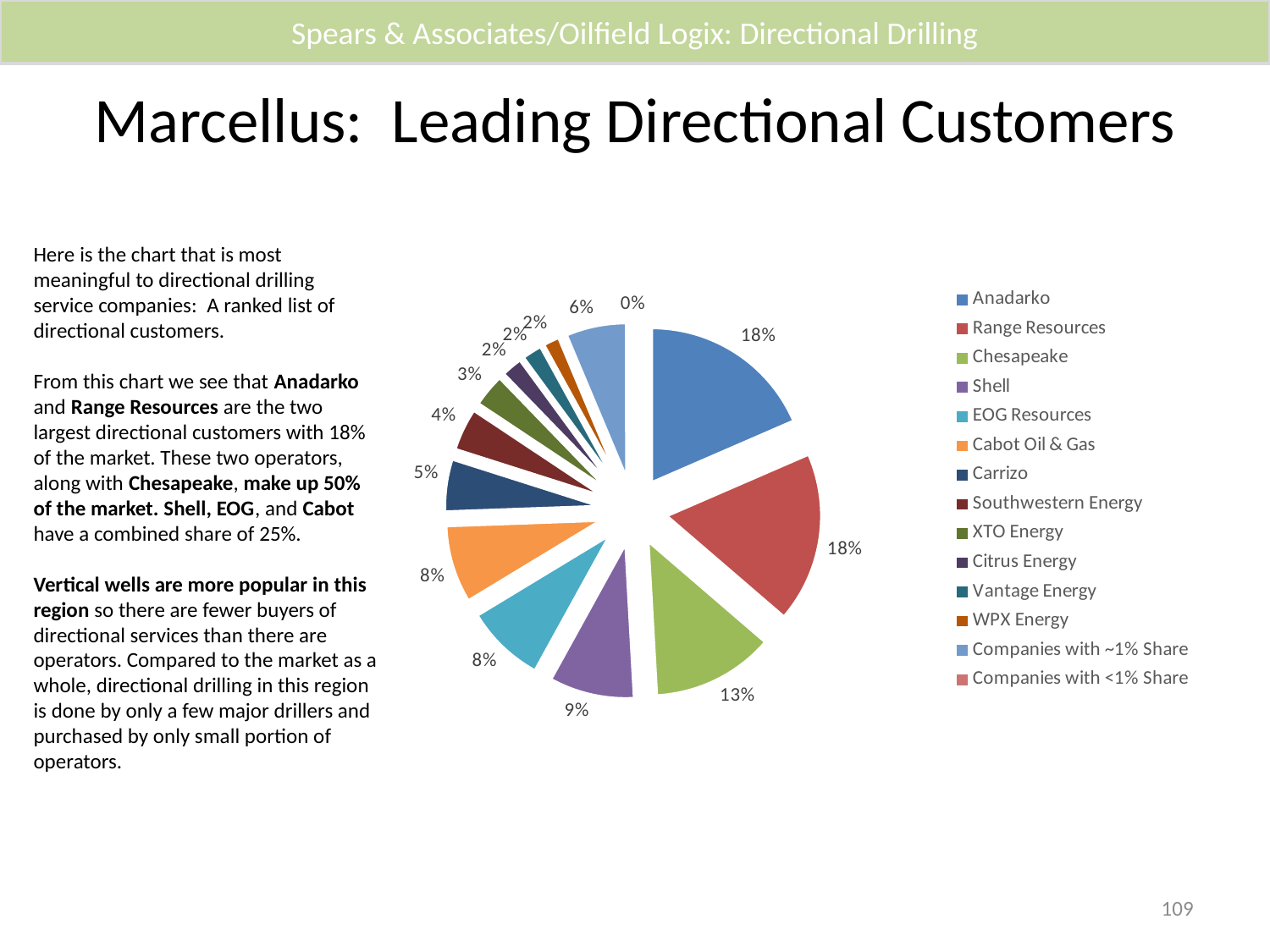
What share of the pie does Shell hold? 9% How many entries does the legend list? 14 What share of the pie does Carrizo hold? 5% What share of the pie is labelled for Companies with ~1% Share? 6% What is the difference between the share for Range Resources and the share for Chesapeake? 5% What is the title of the slide containing the pie chart? Marcellus: Leading Directional Customers What share of the pie does Southwestern Energy hold? 4% Which is larger, the share for Chesapeake or the share for Shell? Chesapeake What share of the pie does Anadarko hold? 18% Which legend entry has the smallest share of the pie? Companies with <1% Share What share of the pie does Chesapeake hold? 13% What type of chart is shown on the slide? Pie chart